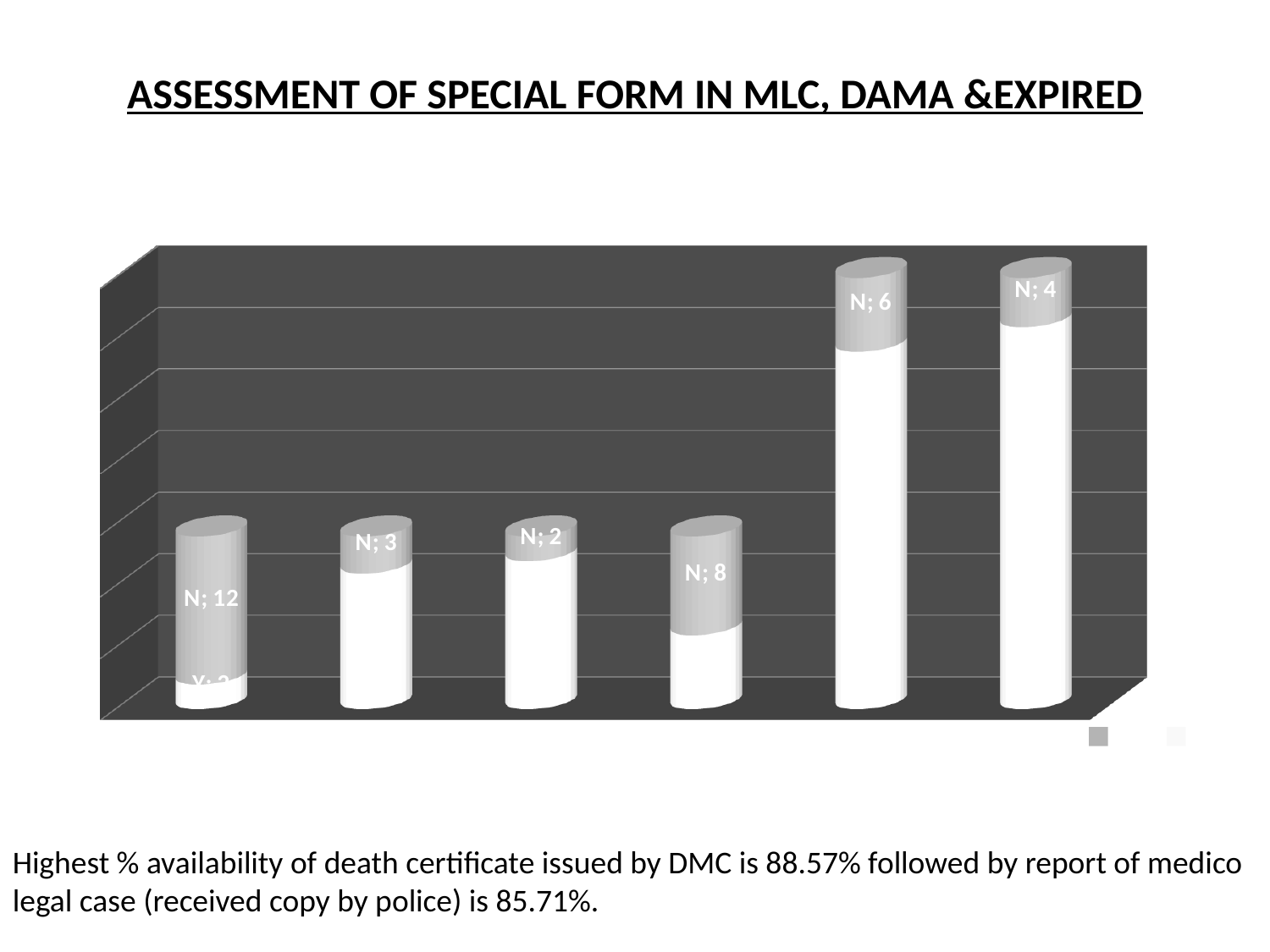
What is the N value labelled on the fourth bar from the left? 8 Which bar has the lowest labelled N value? The third bar from the left What is the N value labelled on the sixth (rightmost) bar? 4 Which bar has the highest labelled N value? The first (leftmost) bar How many bars are plotted in the chart? 6 What is the N value labelled on the third bar from the left? 2 What is the title of the slide containing the chart? ASSESSMENT OF SPECIAL FORM IN MLC, DAMA &EXPIRED What is the N value labelled on the second bar from the left? 3 What is the difference between the N value of the first bar and the N value of the fourth bar? 4 What kind of chart is shown on the slide? Bar chart What is the N value labelled on the first (leftmost) bar? 12 What is the N value labelled on the fifth bar from the left? 6